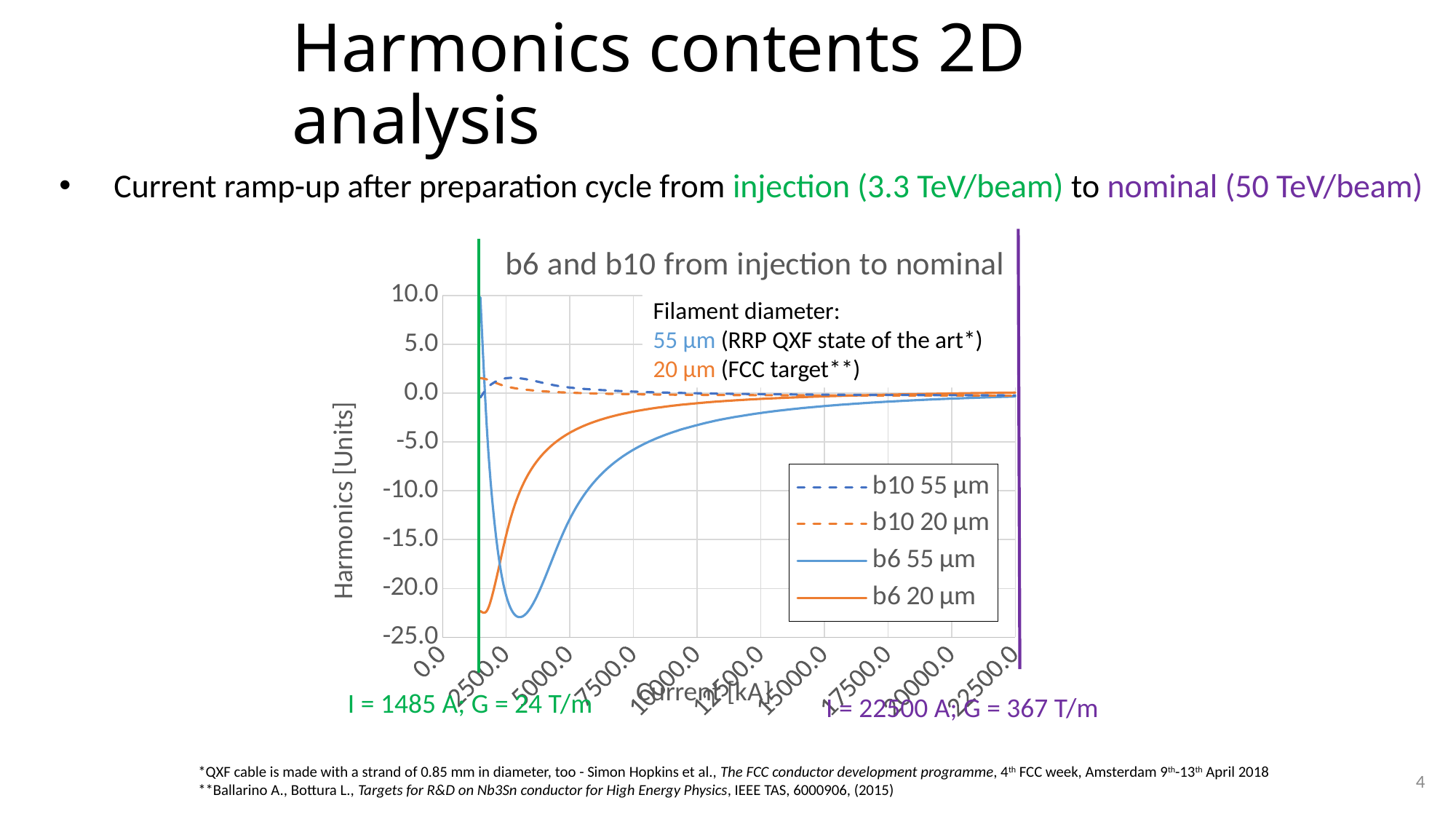
Which series in the legend are drawn with dashed lines? b10 55 µm and b10 20 µm After reaching its minimum, does the b6 55 µm series rise or fall as the current increases toward 22500.0 kA? rise Is the value of the b6 20 µm series at a current of 5000.0 kA greater or less than -10.0? greater What kind of chart is shown on the slide? line chart How many tick labels are shown on the horizontal (Current) axis of the chart? 10 Is the value of the b6 55 µm series at a current of 10000.0 kA greater or less than -5.0? greater What is the label of the vertical axis of the chart? Harmonics [Units] Is the highest value reached by the b10 55 µm series greater or less than 5.0? less At a current of 5000.0 kA, which series has the larger (less negative) value: b6 55 µm or b6 20 µm? b6 20 µm What is the title of the chart? b6 and b10 from injection to nominal How many series does the legend of the chart list? 4